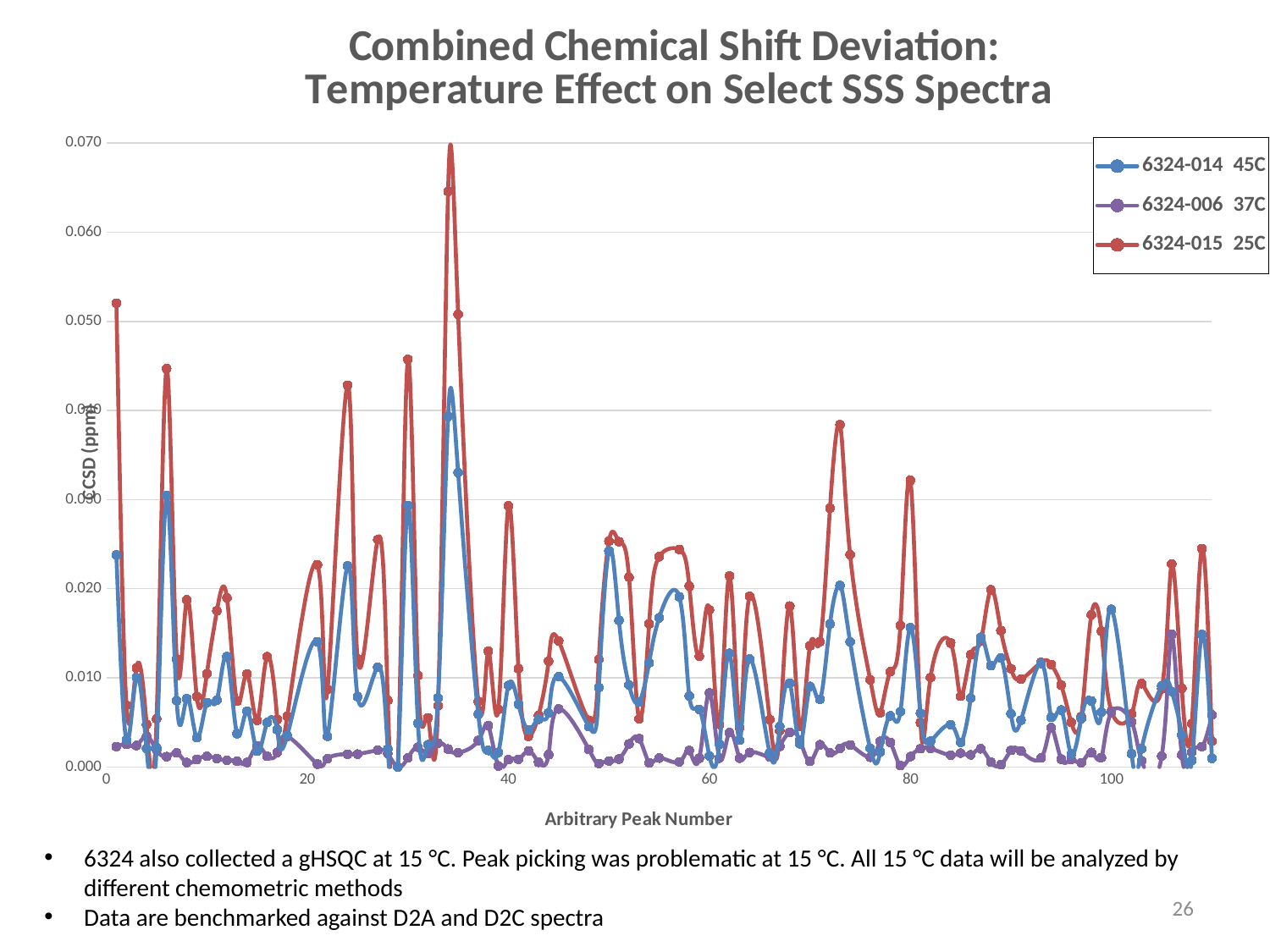
Is the highest value of the 6324-014 45C series greater or less than 0.030? greater How many series does the legend list? 3 Is the highest value of the 6324-006 37C series greater or less than 0.020? less Is the value of the 6324-015 25C series at peak number 1 greater or less than 0.040? greater Which series reaches the highest value on the chart? 6324-015 25C Around peak number 6, which series has the larger value, 6324-015 25C or 6324-006 37C? 6324-015 25C What is the title of the chart? Combined Chemical Shift Deviation: Temperature Effect on Select SSS Spectra What kind of chart is shown on the slide? line chart Around peak number 34, which series has the larger value, 6324-015 25C or 6324-014 45C? 6324-015 25C Which series stays lowest across the chart? 6324-006 37C What is the label of the x axis? Arbitrary Peak Number